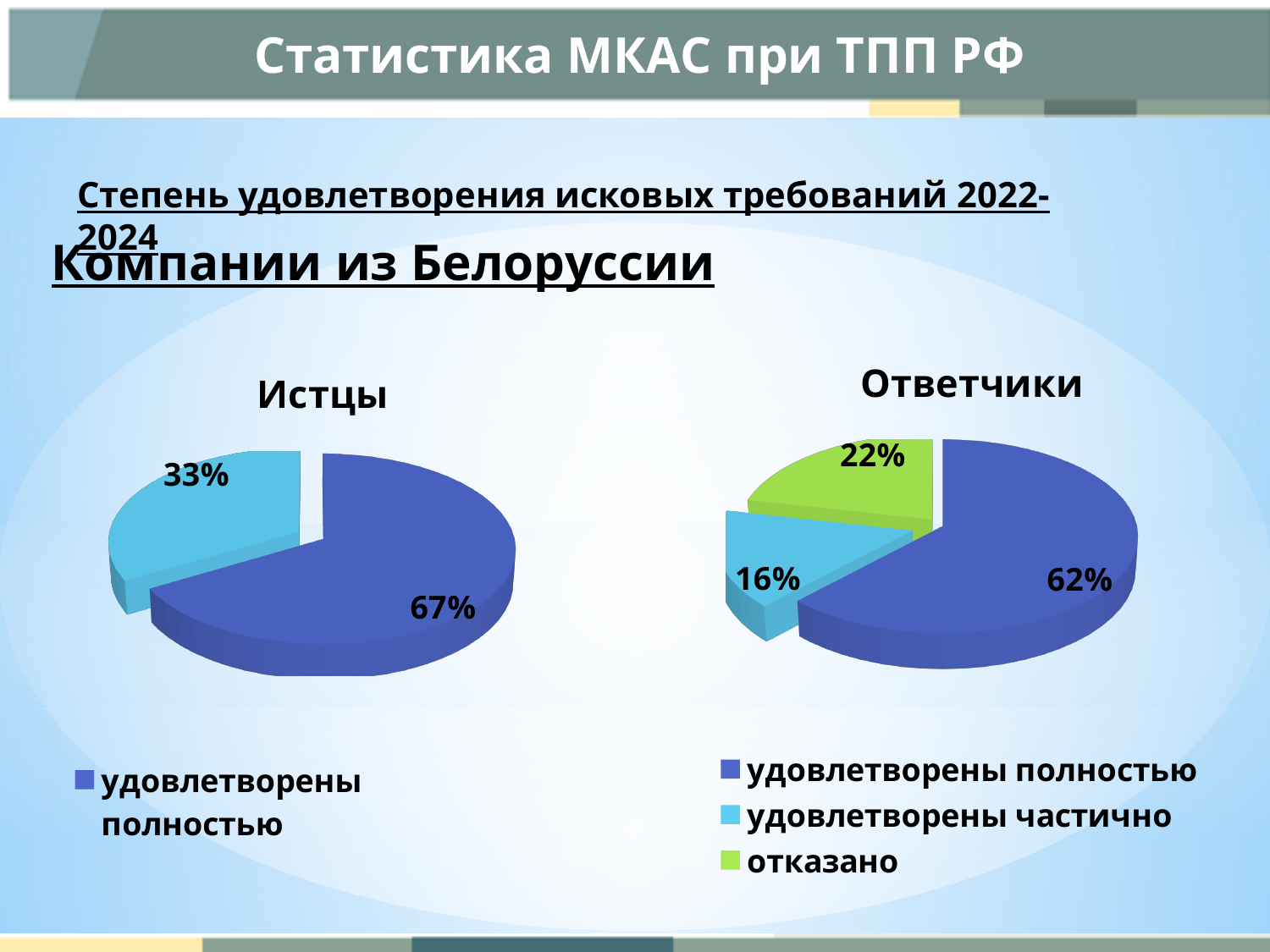
Which is larger: the "удовлетворены полностью" share in the "Истцы" chart or in the "Ответчики" chart? Истцы How many entries does the legend of the "Ответчики" chart list? 3 In the "Ответчики" chart, which category has the smallest slice? удовлетворены частично What kind of chart is the "Истцы" chart? pie chart In the "Ответчики" chart, which category has the largest slice? удовлетворены полностью In the "Истцы" chart, what share is labelled on the light blue slice? 33% In the "Истцы" chart, what share is labelled on the dark blue slice (удовлетворены полностью)? 67% In the "Ответчики" chart, what is the difference in percentage points between "отказано" and "удовлетворены частично"? 6 In the "Ответчики" chart, what share is shown for "отказано"? 22% How many slices does the "Ответчики" chart have? 3 In the "Ответчики" chart, what share is shown for "удовлетворены частично"? 16% In the "Ответчики" chart, what share is shown for "удовлетворены полностью"? 62%